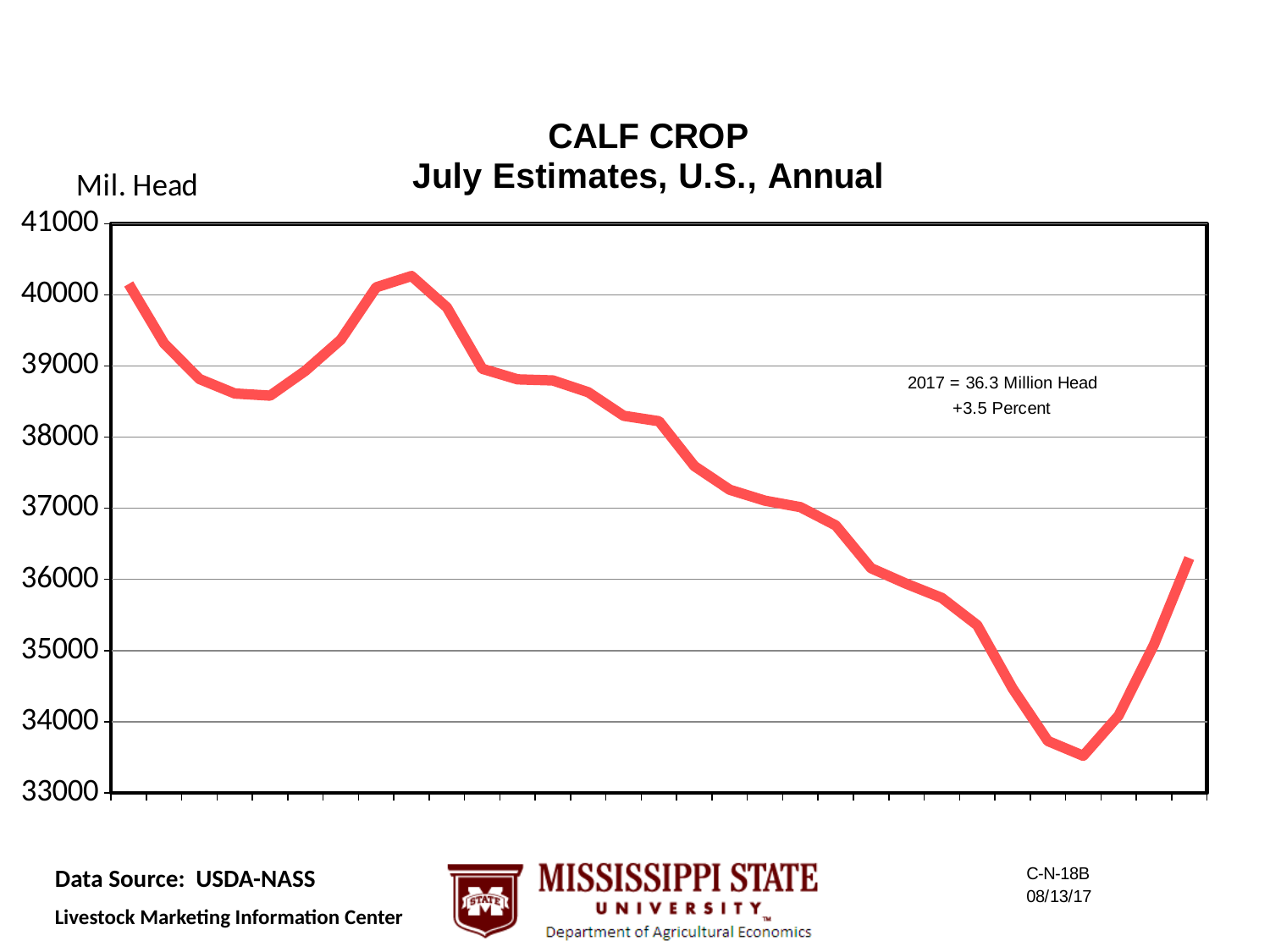
What kind of chart is shown on the slide? line chart What is the lowest value shown on the vertical axis of the chart? 33000 Over the full span of the x axis, do the plotted values generally rise or fall? fall According to the annotation on the chart, what is the 2017 calf crop value? 36.3 Million Head Is the value at the first point on the line greater or less than 40000? greater Which is larger, the value at the first point on the line or the value at the last point? the first point Is the value at the last point on the line greater or less than 36000? greater Is the lowest point on the line greater or less than 34000? less According to the annotation on the chart, what is the percent change for 2017? +3.5 Percent What unit label is shown on the vertical axis of the chart? Mil. Head What is the title of the chart? CALF CROP July Estimates, U.S., Annual